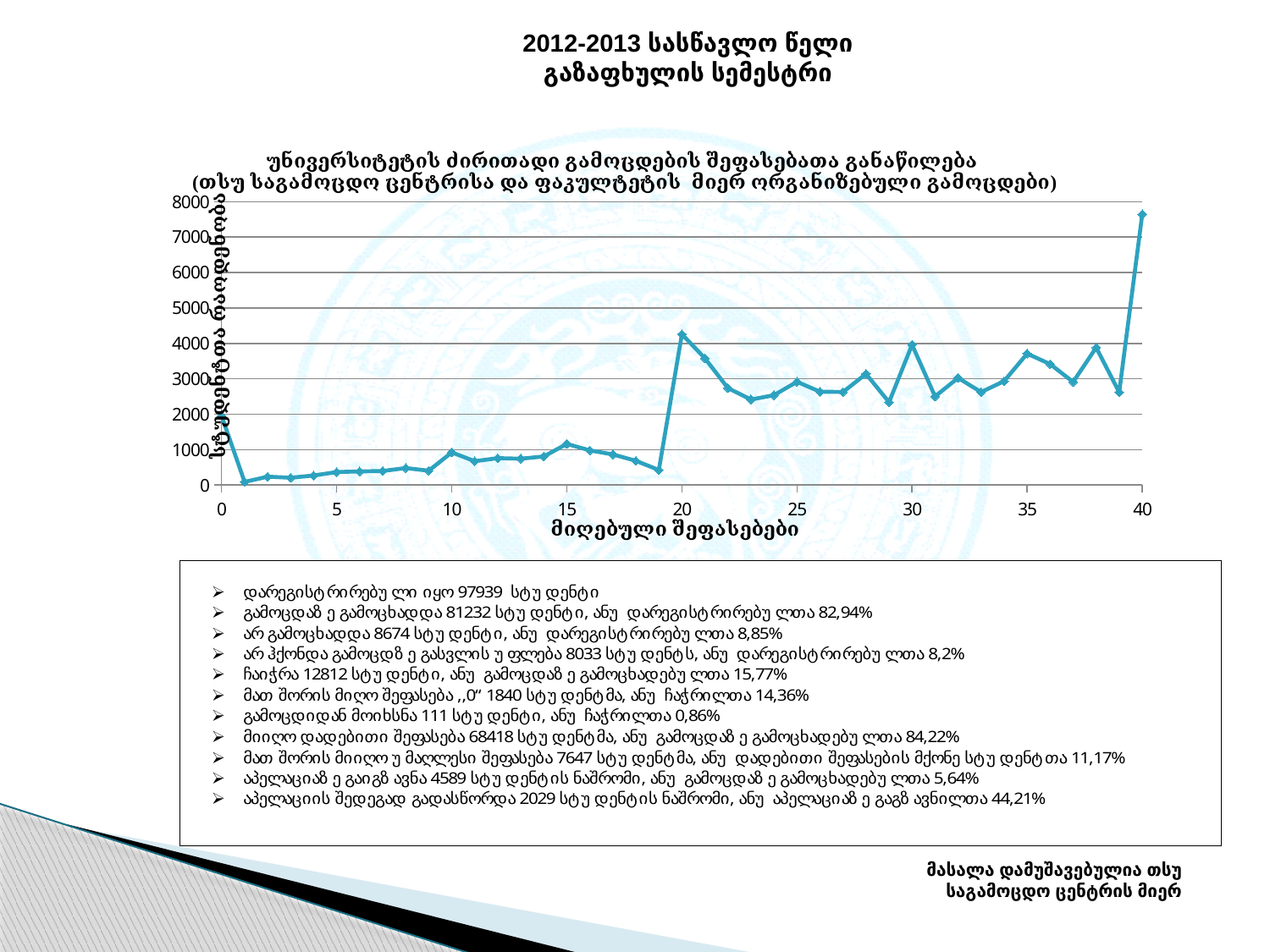
Which has the larger value: score 19 or score 20? score 20 Is the value at score 10 greater or less than 2000? less At which score on the x axis does the line reach its highest value? 40 Do the values rise or fall between score 20 and score 23? fall Is the value at score 30 greater or less than 3000? greater What is the highest tick value shown on the y axis? 8000 At which score on the x axis does the line reach its lowest value? 1 What kind of chart is shown on the slide? line chart Is the value at score 20 greater or less than 3000? greater Which has the larger value: score 0 or score 40? score 40